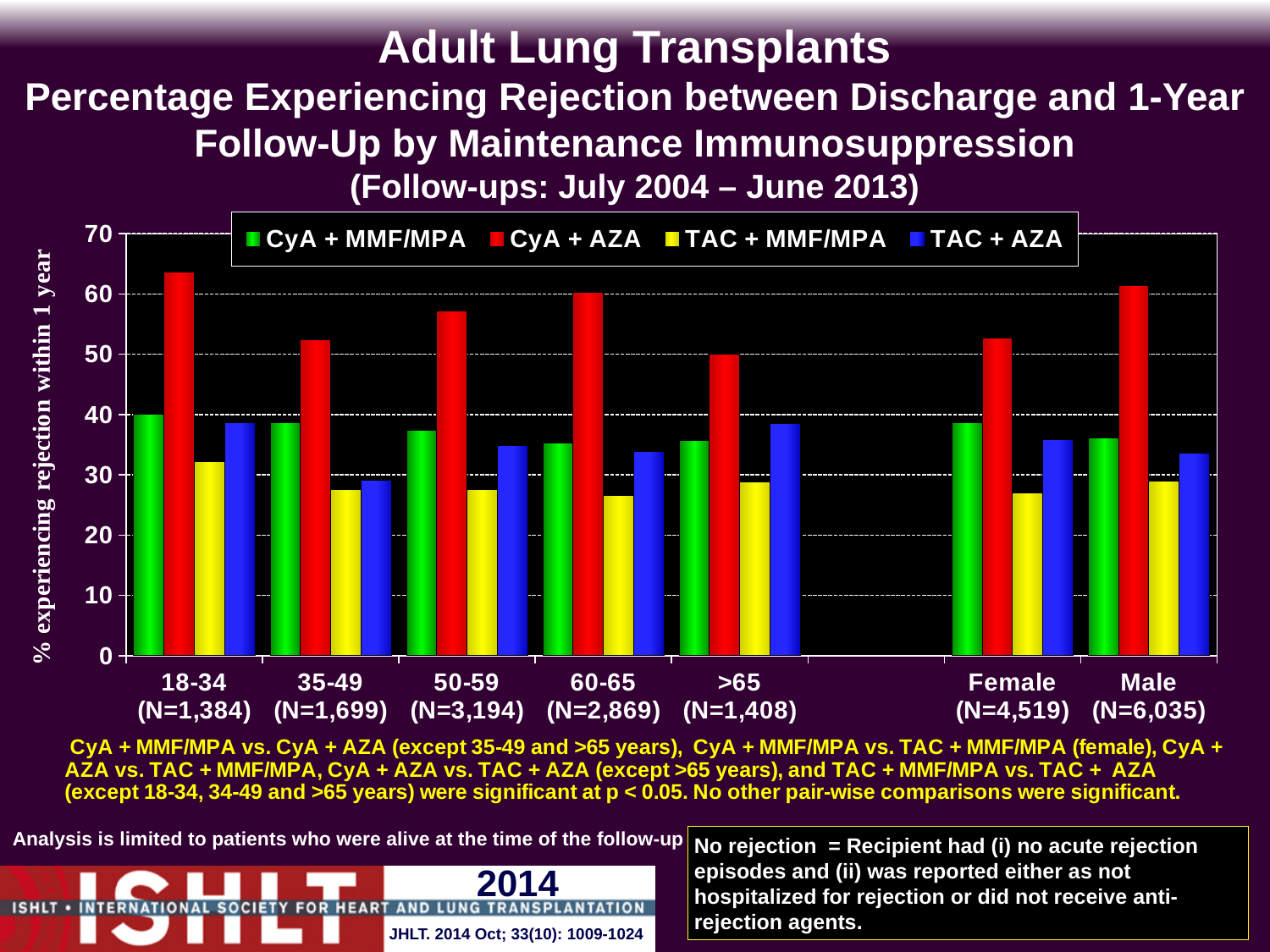
How many series does the legend list? 4 Which immunosuppression regimen has the highest rejection percentage in the 18-34 age group? CyA + AZA What kind of chart is shown on the slide? bar chart What is the label of the y axis? % experiencing rejection within 1 year Which is larger, the TAC + AZA value for 18-34 or for 35-49? 18-34 How many categories are shown along the x axis? 7 Is the value for CyA + AZA in the 50-59 age group greater or less than 50? greater What colour represents TAC + AZA in the chart? blue Is the value for TAC + MMF/MPA in the 60-65 age group greater or less than 30? less Is the value for CyA + AZA in the 18-34 age group greater or less than 60? greater Which immunosuppression regimen has the lowest rejection percentage for Male recipients? TAC + MMF/MPA Which is larger, the CyA + AZA value for 18-34 or for >65? 18-34